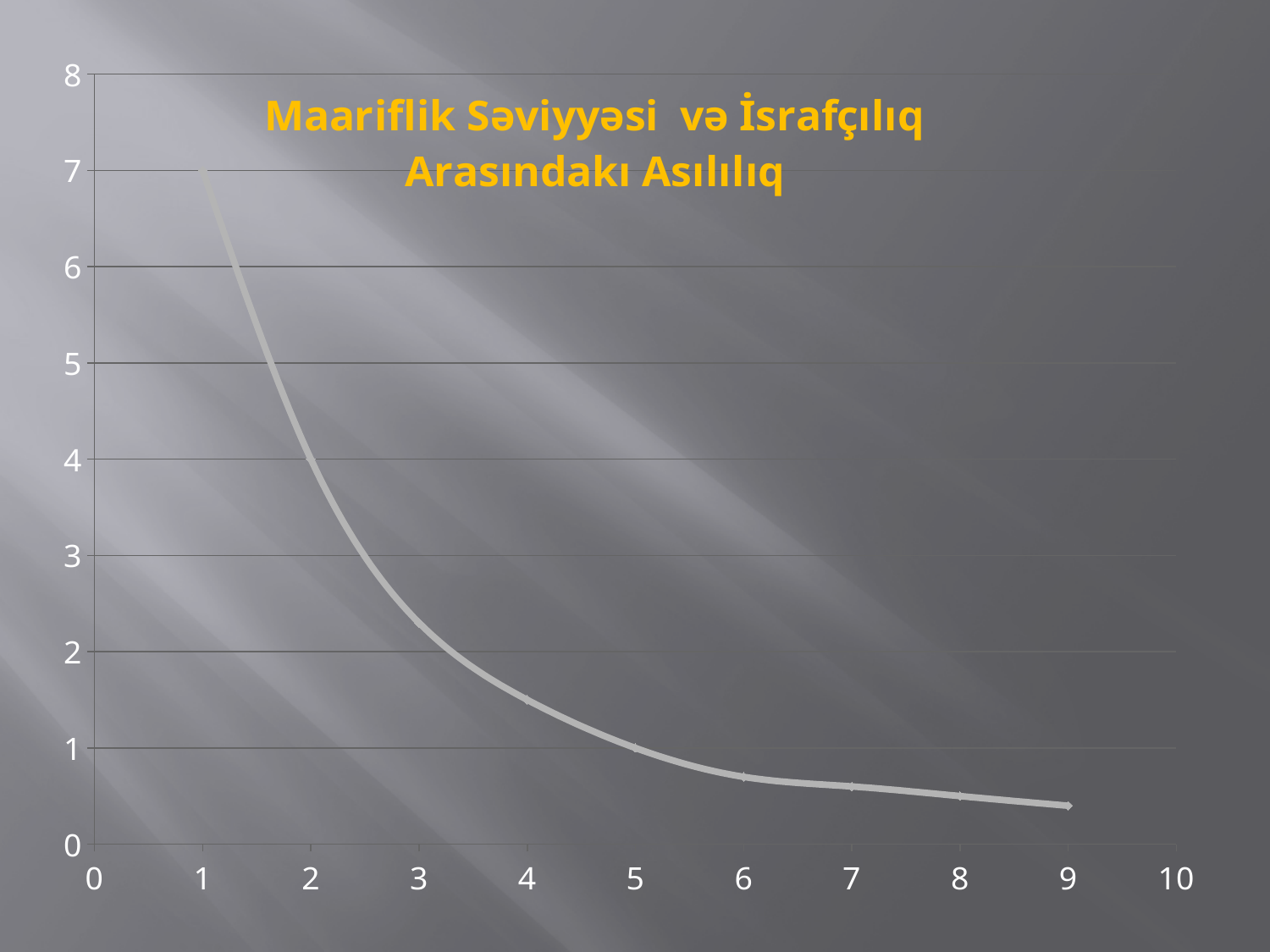
What is the y value of the curve at x = 2? 4 Do the values rise or fall as x increases from 1 to 9? fall Is the value at x = 3 greater or less than 3? less What is the title of the chart? Maariflik Səviyyəsi və İsrafçılıq Arasındakı Asılılıq Which is larger, the value at x = 2 or the value at x = 5? x = 2 At which x value does the curve reach its lowest y value? 9 What is the y value of the curve at x = 5? 1 What kind of chart is shown on the slide? line chart What is the y value of the curve at x = 1? 7 Is the value at x = 4 greater or less than 1? greater At which x value does the curve reach its highest y value? 1 Is the value at x = 9 greater or less than 1? less